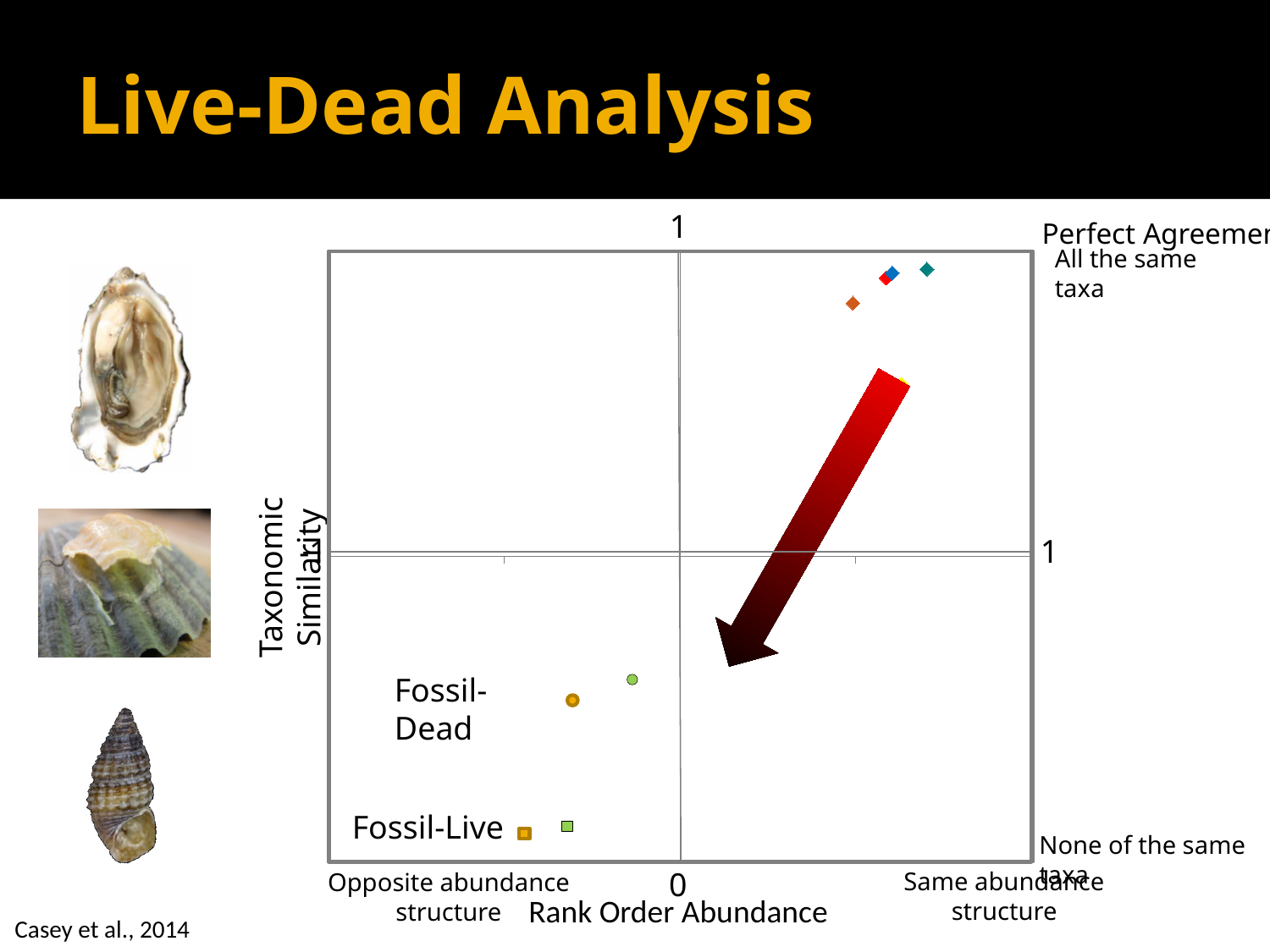
Are the diamond-shaped points in the upper right plotted at a Rank Order Abundance greater or less than 0? greater Which group has higher Taxonomic Similarity, the diamond-shaped points in the upper right or the Fossil-Live points? the diamond-shaped points in the upper right What is the title of the y axis of the chart? Taxonomic Similarity Are the Fossil-Dead points plotted at a Rank Order Abundance greater or less than 0? less What is the title of the x axis of the chart? Rank Order Abundance What kind of chart is shown on the slide? scatter chart What value is marked at the top of the y axis? 1 Which group has higher Taxonomic Similarity, the Fossil-Dead points or the Fossil-Live points? Fossil-Dead How many circle markers are plotted for the Fossil-Dead group? 2 How many square markers are plotted for the Fossil-Live group? 2 Are the Fossil-Live points plotted at a Rank Order Abundance greater or less than 0? less Which labelled group of points has the lowest Taxonomic Similarity? Fossil-Live